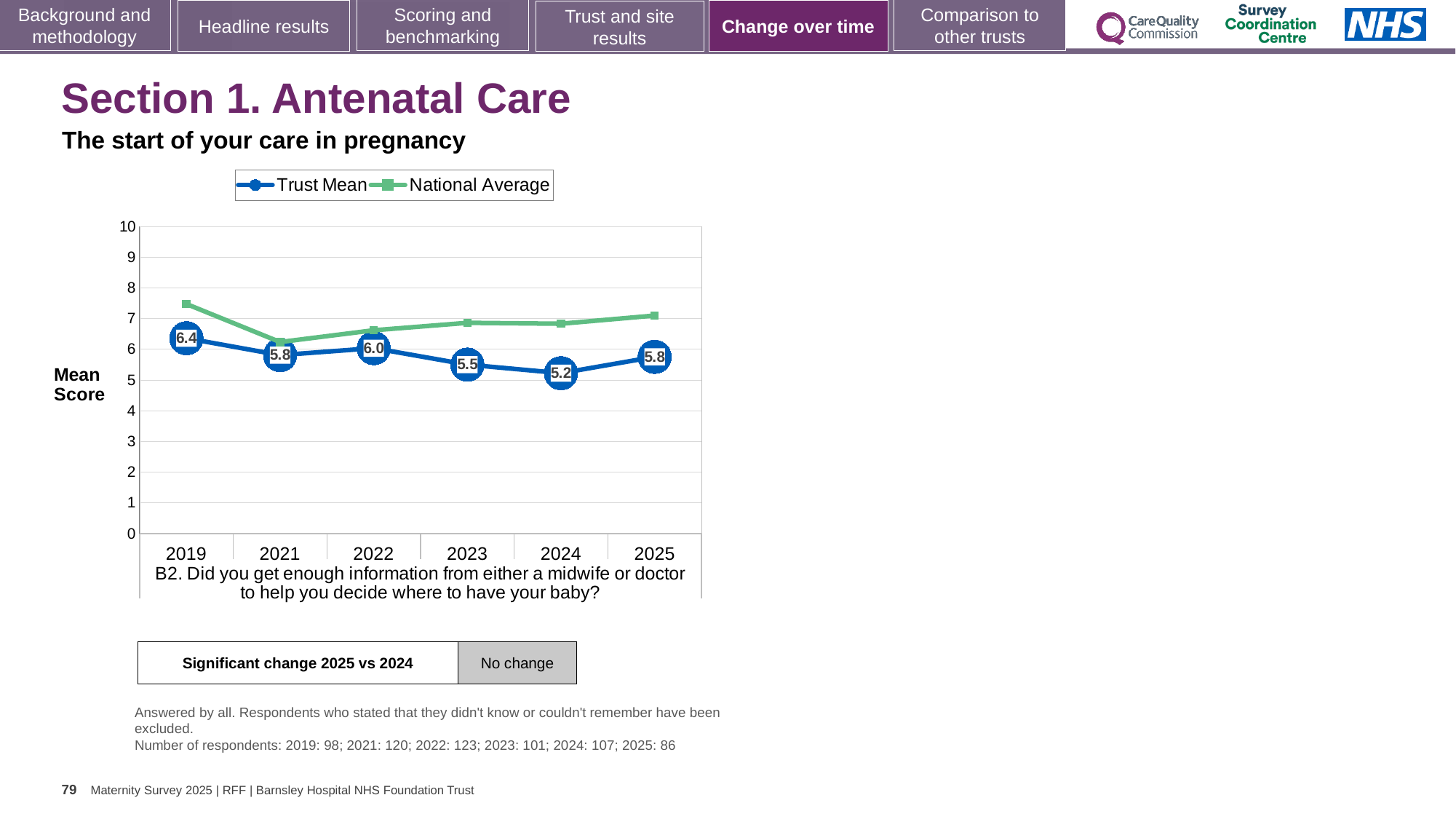
What is the Trust Mean for 2024? 5.2 In which year is the Trust Mean lowest? 2024 What is the Trust Mean for 2019? 6.4 Is the National Average for 2019 greater or less than 7? greater Does the Trust Mean rise or fall from 2022 to 2024? Fall How many series does the legend list? 2 How many years are shown on the x axis? 6 Which is larger, the Trust Mean in 2022 or in 2023? 2022 What kind of chart is shown? Line chart What is the difference between the Trust Mean in 2019 and in 2024? 1.2 In which year is the Trust Mean highest? 2019 What is the Trust Mean for 2025? 5.8